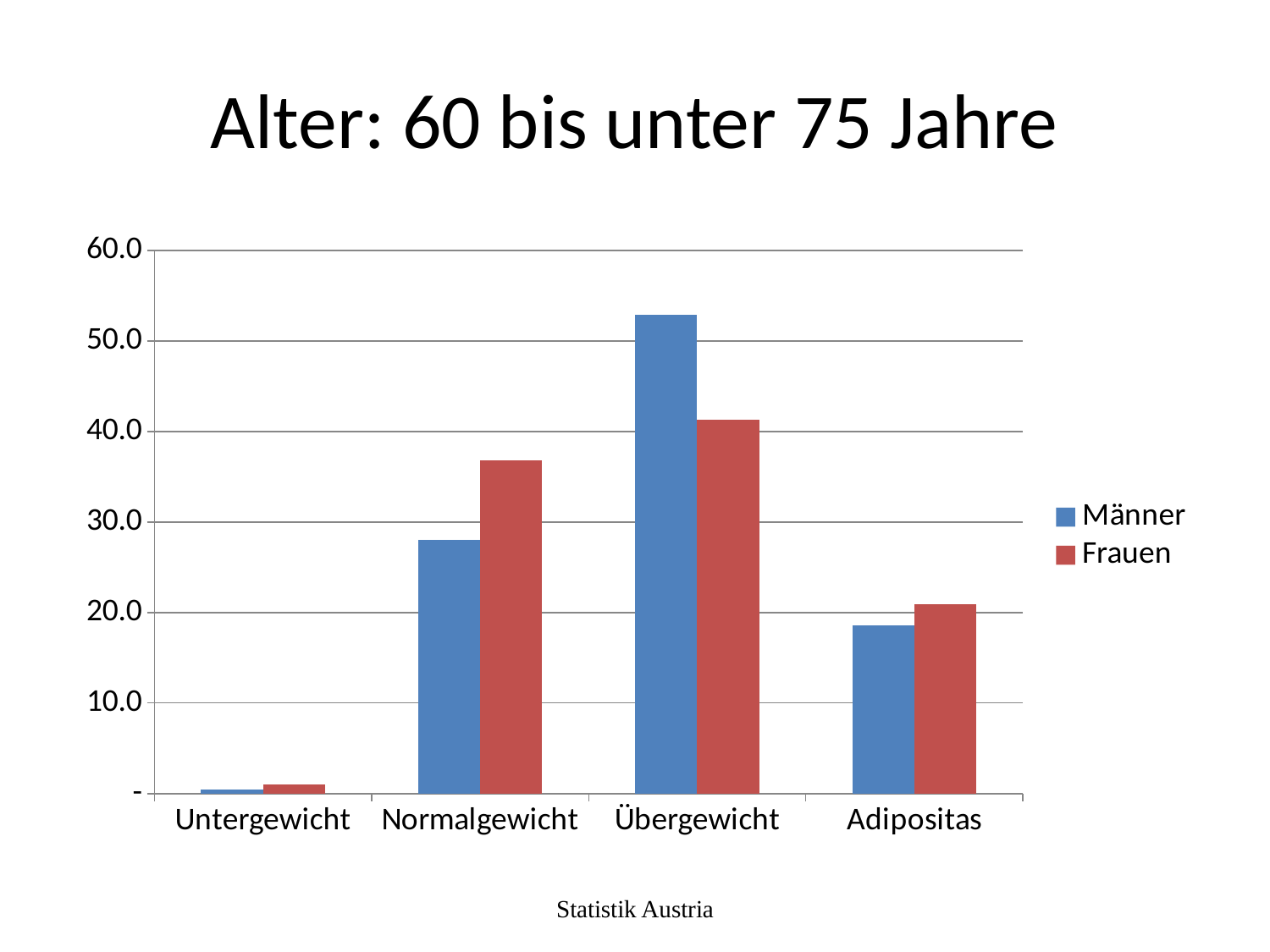
How many categories are shown on the x axis? 4 In Normalgewicht, which series has the larger value, Männer or Frauen? Frauen What is the title of the chart? Alter: 60 bis unter 75 Jahre Which category has the lowest value for Frauen? Untergewicht How many series does the legend list? 2 Is the value for Frauen in Übergewicht greater or less than 30? greater Which category has the highest value for Männer? Übergewicht In Übergewicht, which series has the larger value, Männer or Frauen? Männer Is the value for Männer in Normalgewicht greater or less than 30? less What kind of chart is shown on the slide? bar chart Is the value for Frauen in Normalgewicht greater or less than 40? less